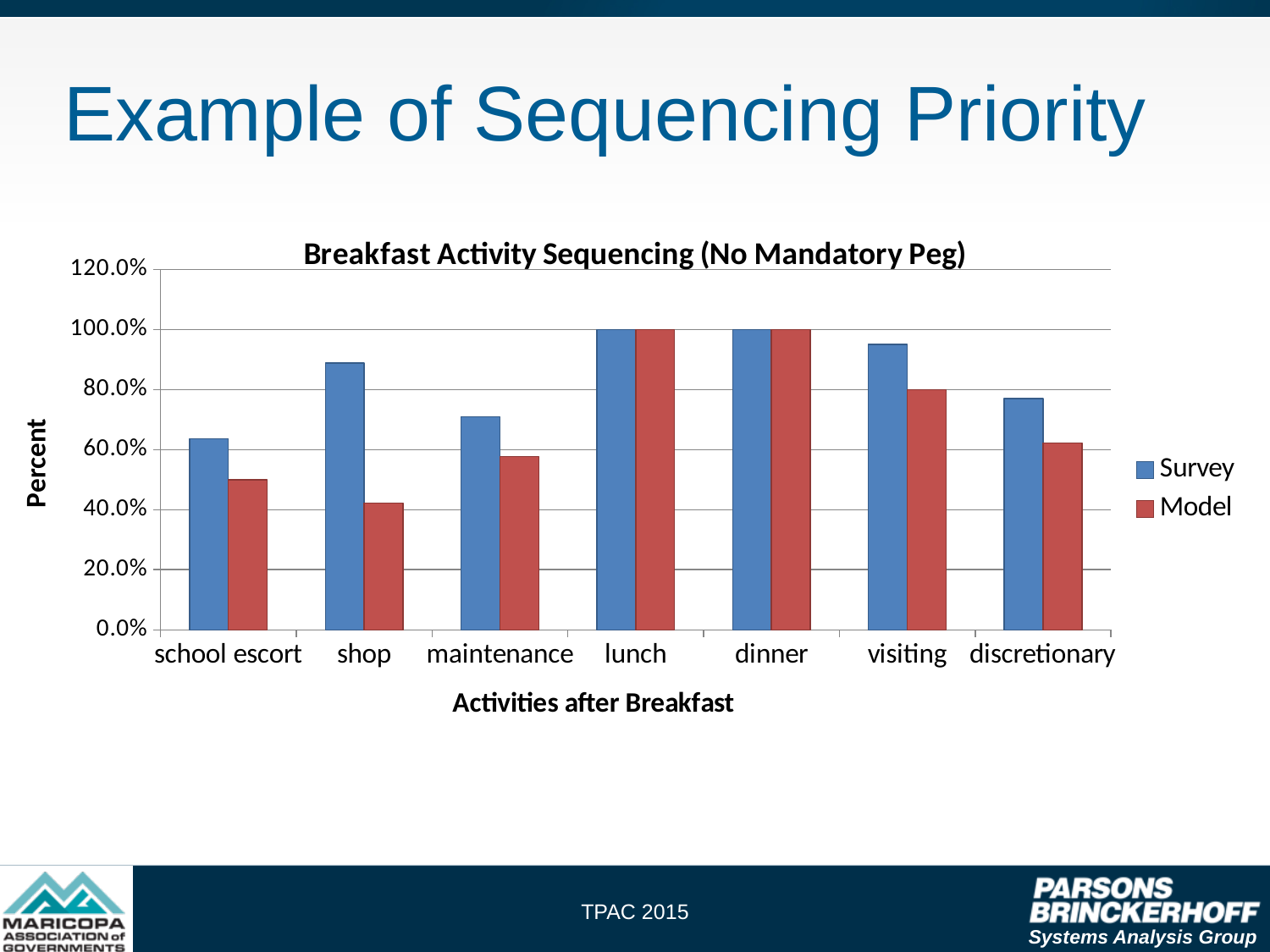
What is the Survey value for lunch? 100.0% Which activity has the lowest Survey value? school escort How many activity categories are shown on the x axis? 7 Is the Survey value for visiting greater or less than 80.0%? greater For shop, which is larger, the Survey value or the Model value? Survey Is the Survey value for shop greater or less than 80.0%? greater Which activity has the lowest Model value? shop What is the title of the chart? Breakfast Activity Sequencing (No Mandatory Peg) Is the Model value for shop greater or less than 60.0%? less What is the Model value for dinner? 100.0% What kind of chart is shown on the slide? bar chart How many series does the legend list? 2